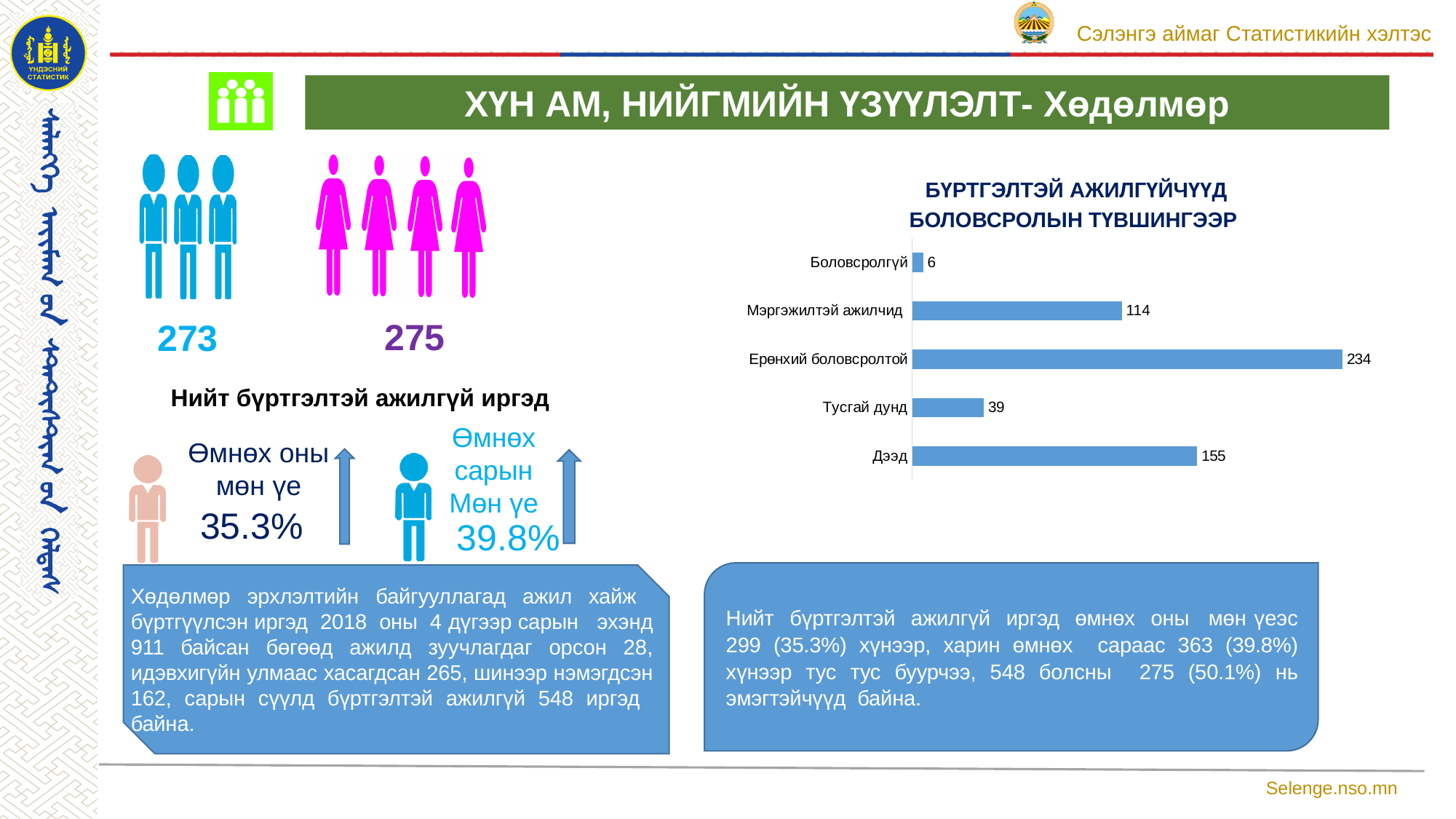
What kind of chart is БҮРТГЭЛТЭЙ АЖИЛГҮЙЧҮҮД БОЛОВСРОЛЫН ТҮВШИНГЭЭР? Bar chart Which category has the lowest value in the chart? Боловсролгүй What is the value for Дээд in the chart? 155 What is the difference between the values for Ерөнхий боловсролтой and Дээд? 79 What is the value for Боловсролгүй in the chart? 6 Which is larger, the value for Дээд or the value for Мэргэжилтэй ажилчид? Дээд What is the value for Тусгай дунд in the chart? 39 What is the difference between the values for Мэргэжилтэй ажилчид and Тусгай дунд? 75 Which category has the highest value in the chart? Ерөнхий боловсролтой How many categories are shown in the chart? 5 What is the title of the chart on the right side of the slide? БҮРТГЭЛТЭЙ АЖИЛГҮЙЧҮҮД БОЛОВСРОЛЫН ТҮВШИНГЭЭР What is the value for Ерөнхий боловсролтой in the chart БҮРТГЭЛТЭЙ АЖИЛГҮЙЧҮҮД БОЛОВСРОЛЫН ТҮВШИНГЭЭР? 234